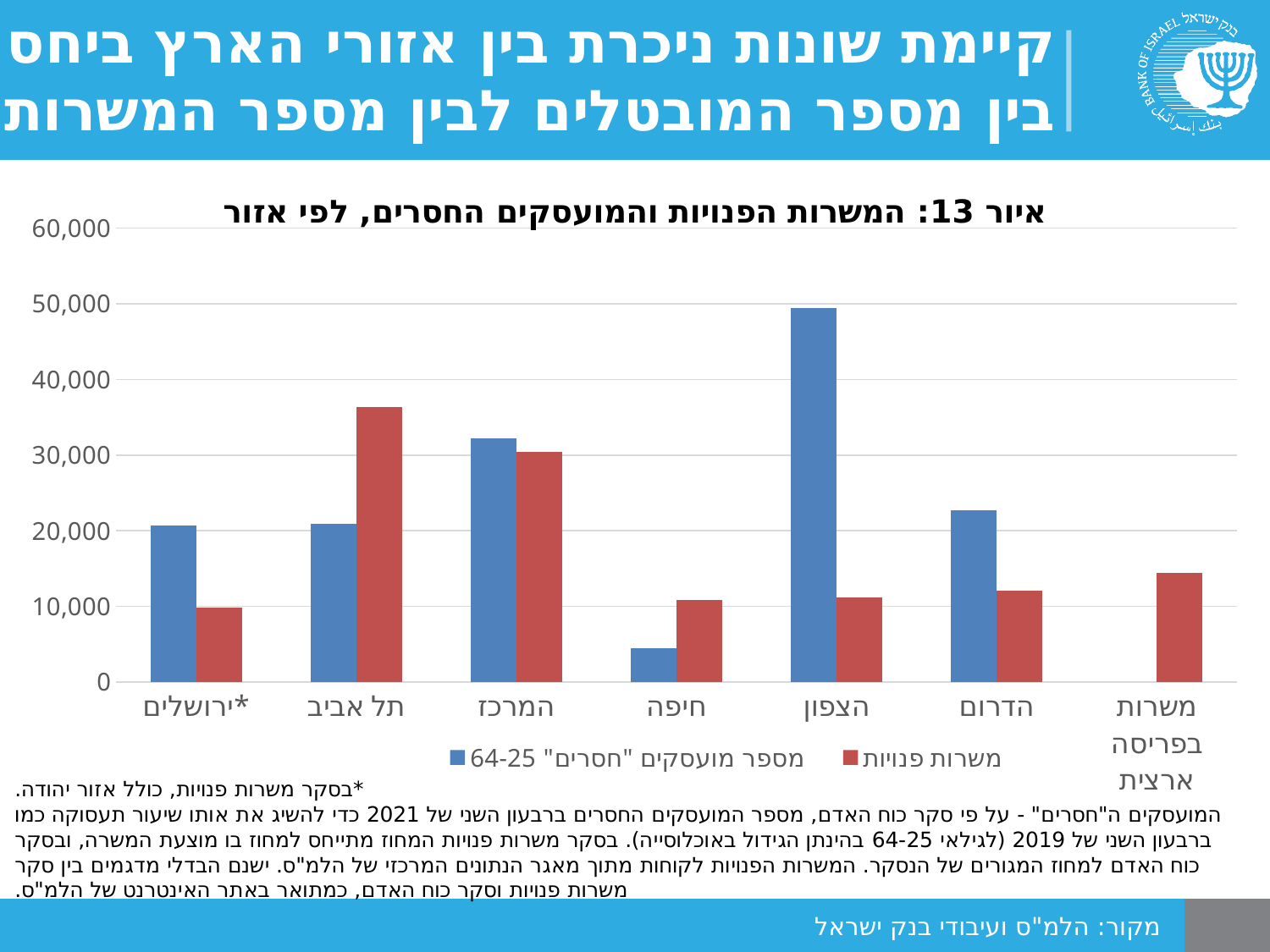
For תל אביב, which series has the larger value: מספר מועסקים "חסרים" 25-64 or משרות פנויות? משרות פנויות What kind of chart is shown on the slide? bar chart How many region categories are shown on the x axis of the chart? 7 Which region has the highest value for the series משרות פנויות? תל אביב Is the value for חיפה in the series מספר מועסקים "חסרים" 25-64 greater or less than 10,000? less Which region has the highest value for the series מספר מועסקים "חסרים" 25-64? הצפון Which region has the lowest value for the series משרות פנויות? ירושלים* Which region has the lowest value for the series מספר מועסקים "חסרים" 25-64? חיפה For הדרום, which series has the larger value: מספר מועסקים "חסרים" 25-64 or משרות פנויות? מספר מועסקים "חסרים" 25-64 How many series does the chart legend list? 2 Is the value for הצפון in the series מספר מועסקים "חסרים" 25-64 greater or less than 40,000? greater What is the title of the chart? איור 13: המשרות הפנויות והמועסקים החסרים, לפי אזור